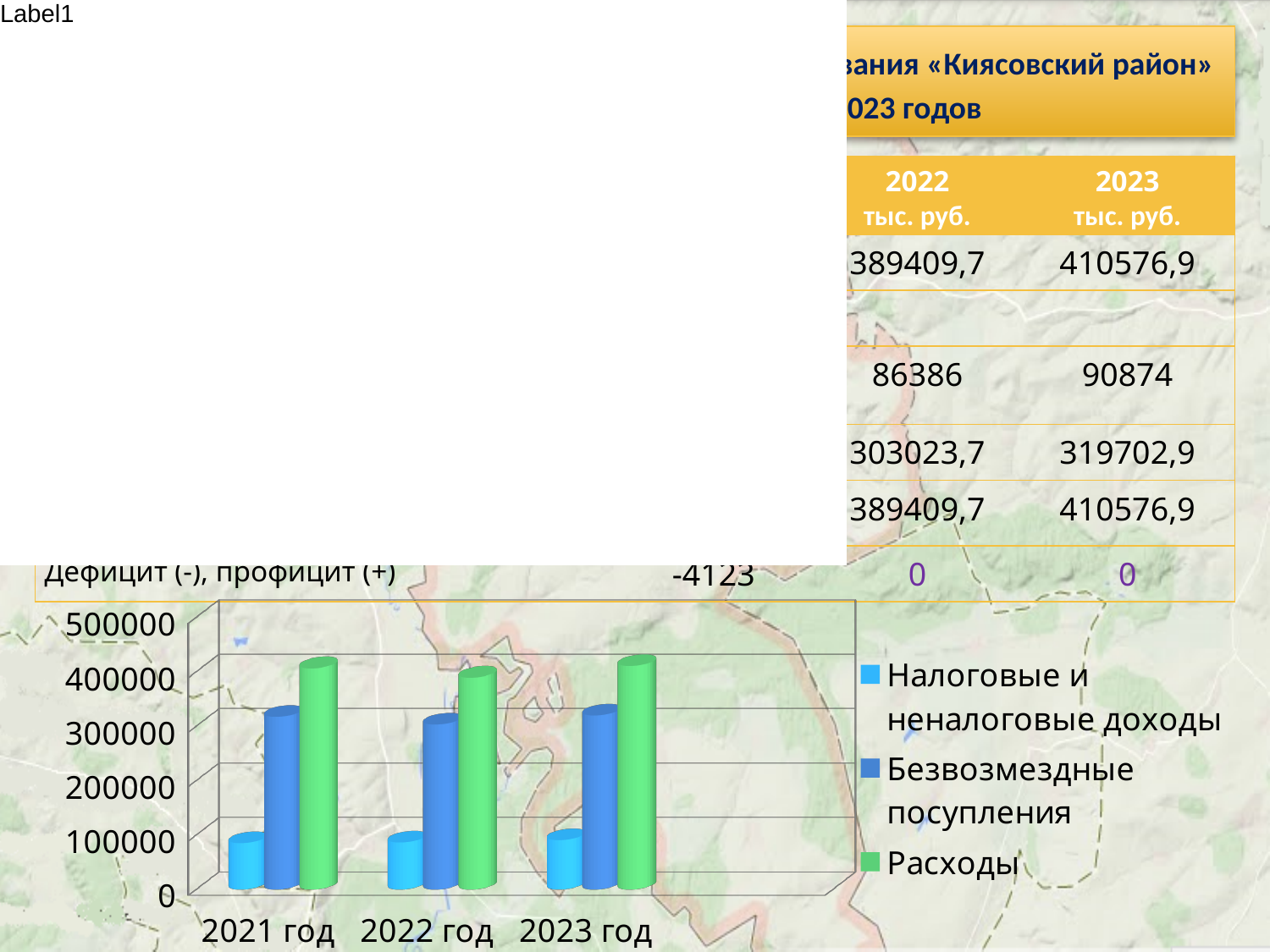
What kind of chart is shown at the bottom of the slide? bar chart What colour are the Расходы bars in the bar chart? green How many series does the legend of the bar chart list? 3 In the bar chart, for 2022 год, which is larger: Расходы or Безвозмездные посупления? Расходы In the bar chart, is the value of Налоговые и неналоговые доходы for 2022 год greater or less than 100000? less In the bar chart, is the value of Расходы for 2021 год greater or less than 500000? less What is the first entry listed in the legend of the bar chart? Налоговые и неналоговые доходы In the bar chart, which series has the highest bar for 2023 год? Расходы In the bar chart, which series has the lowest bar for 2021 год? Налоговые и неналоговые доходы In the bar chart, is the value of Расходы for 2023 год greater or less than 300000? greater How many year categories are shown on the x axis of the bar chart? 3